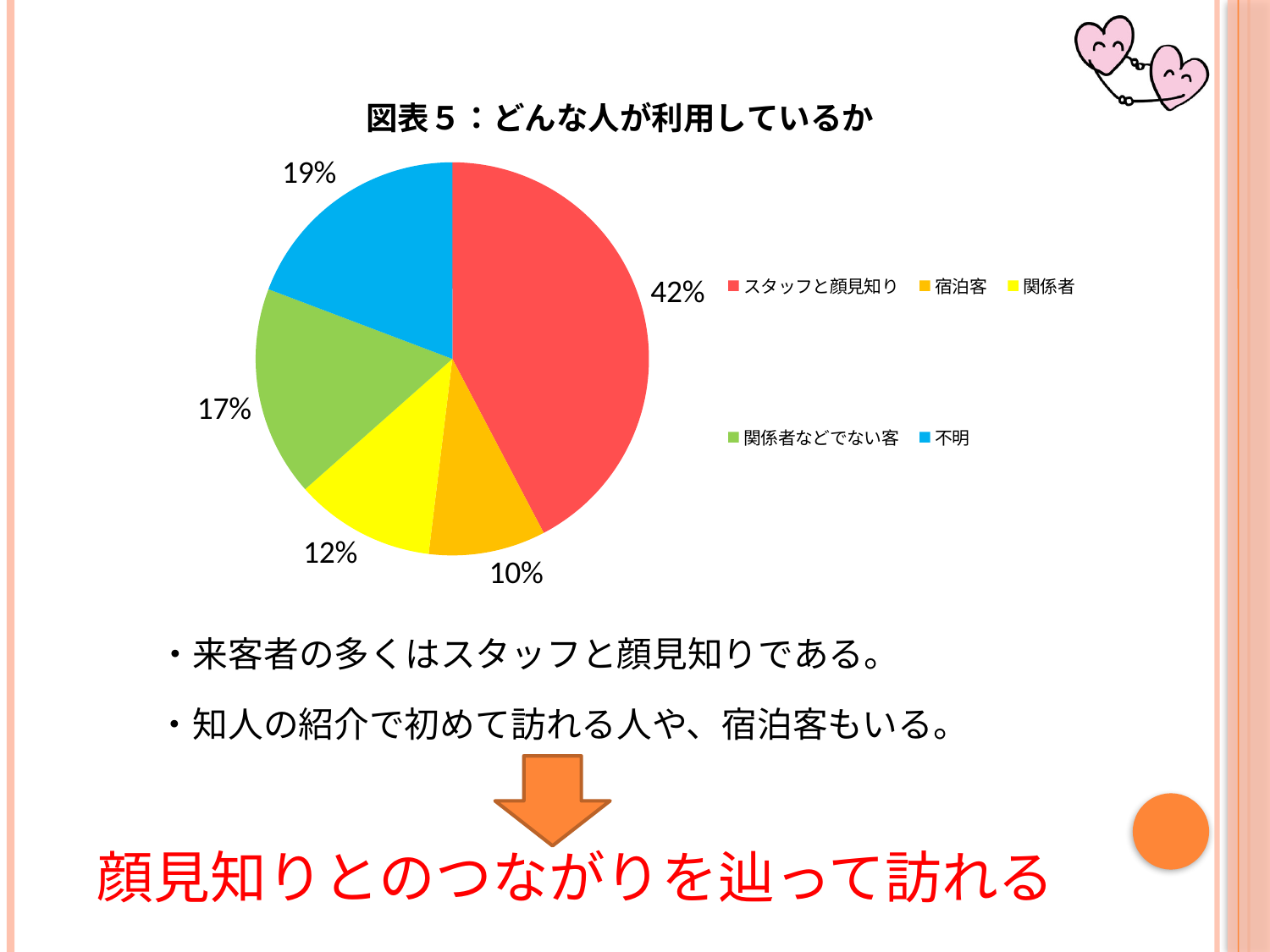
What share of the pie is 関係者? 12% How many categories does the legend list? 5 What share of the pie is 不明? 19% What is the difference in percentage points between スタッフと顔見知り and 不明? 23 Which is larger, the share for 関係者などでない客 or the share for 関係者? 関係者などでない客 What share of the pie is 関係者などでない客? 17% What kind of chart is shown on the slide? Pie chart What is the title of the chart? 図表５：どんな人が利用しているか Which category has the smallest share of the pie? 宿泊客 Which category has the largest share of the pie? スタッフと顔見知り